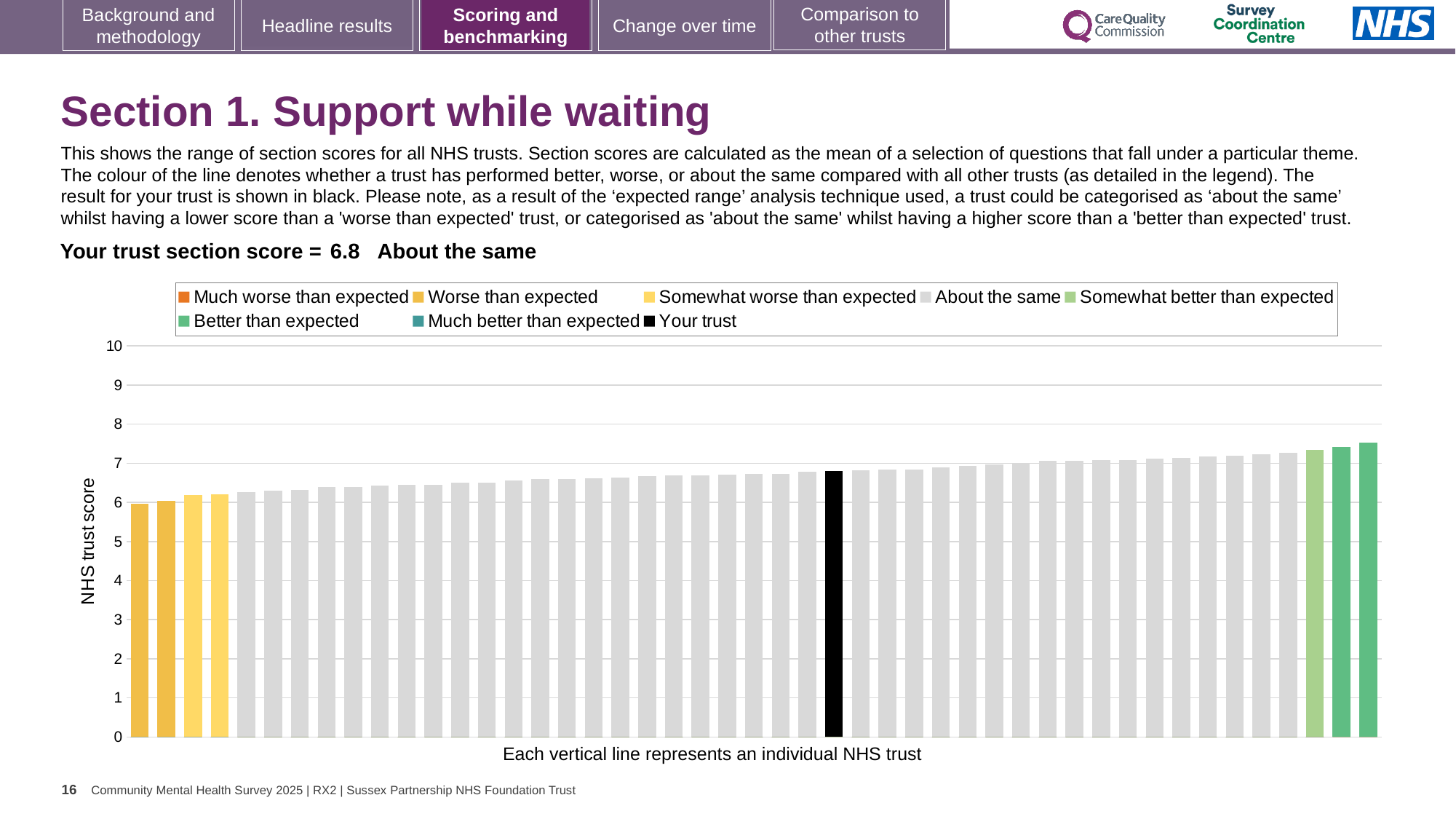
What is the section score for your trust (the black bar)? 6.8 What is the label on the vertical axis of the chart? NHS trust score How many bars on the chart are coloured black? 1 Is the value of the black 'Your trust' bar greater or less than 5? greater Do the bar values rise or fall from left to right along the x axis? rise What kind of chart is shown on the slide? bar chart How many entries does the chart legend list? 8 According to the slide, which category does your trust's section score fall into? About the same Is the value of the tallest bar (rightmost) greater or less than 7? greater Is the value of the tallest bar (rightmost) greater or less than 8? less Which bar is the highest: the leftmost bar or the rightmost bar? the rightmost bar